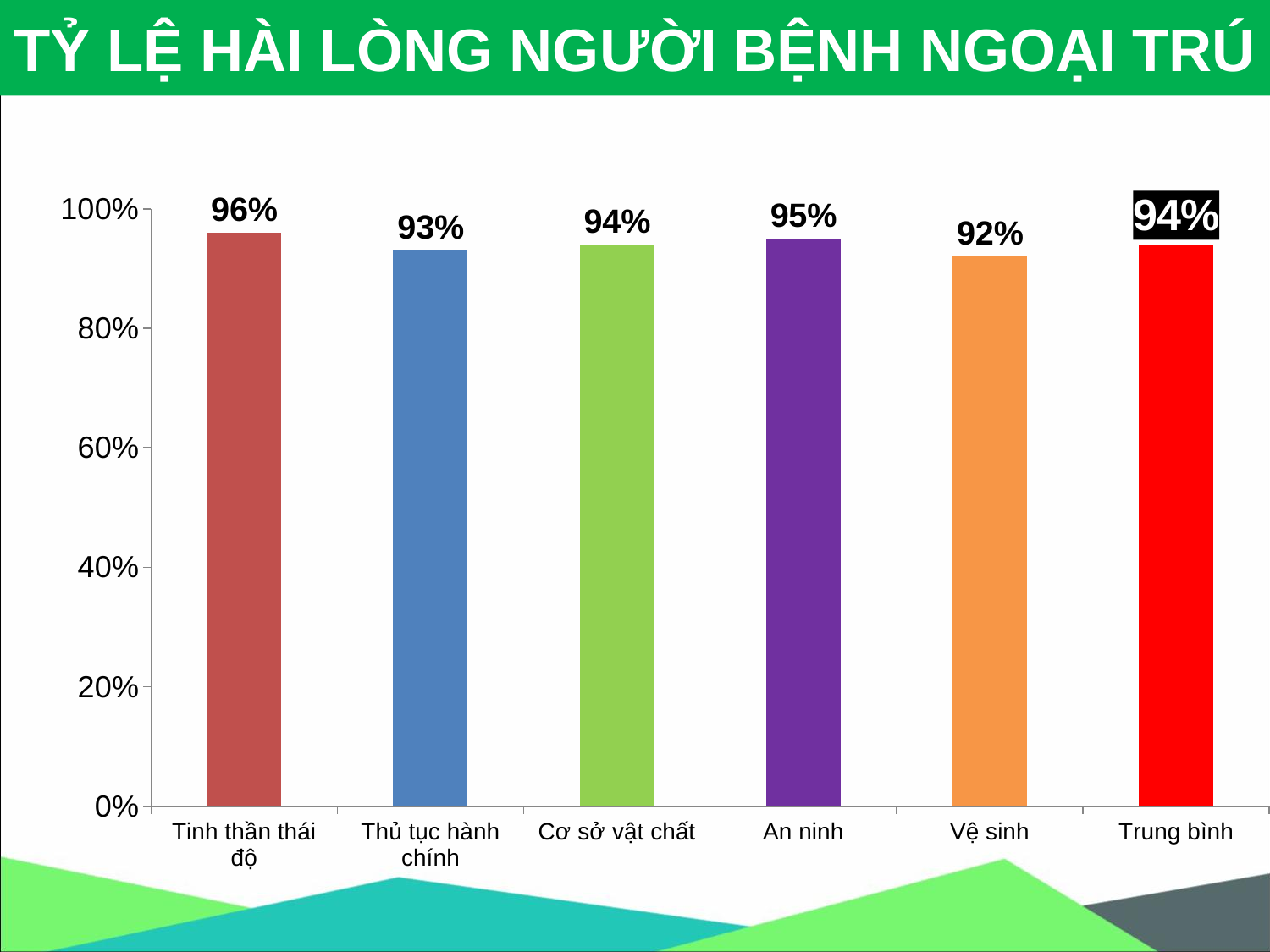
What is the value shown for Vệ sinh? 92% What is the value shown for Trung bình? 94% How many categories are shown on the x axis? 6 What is the value for An ninh? 95% What is the difference between the values for Tinh thần thái độ and Vệ sinh? 4% Which category has the lowest satisfaction rate? Vệ sinh What is the title of the slide? TỶ LỆ HÀI LÒNG NGƯỜI BỆNH NGOẠI TRÚ What kind of chart is shown on the slide? bar chart Which is larger, the value for An ninh or the value for Thủ tục hành chính? An ninh Is the value for Cơ sở vật chất greater or less than 80%? greater What is the satisfaction rate for Tinh thần thái độ? 96% Which category has the highest satisfaction rate? Tinh thần thái độ